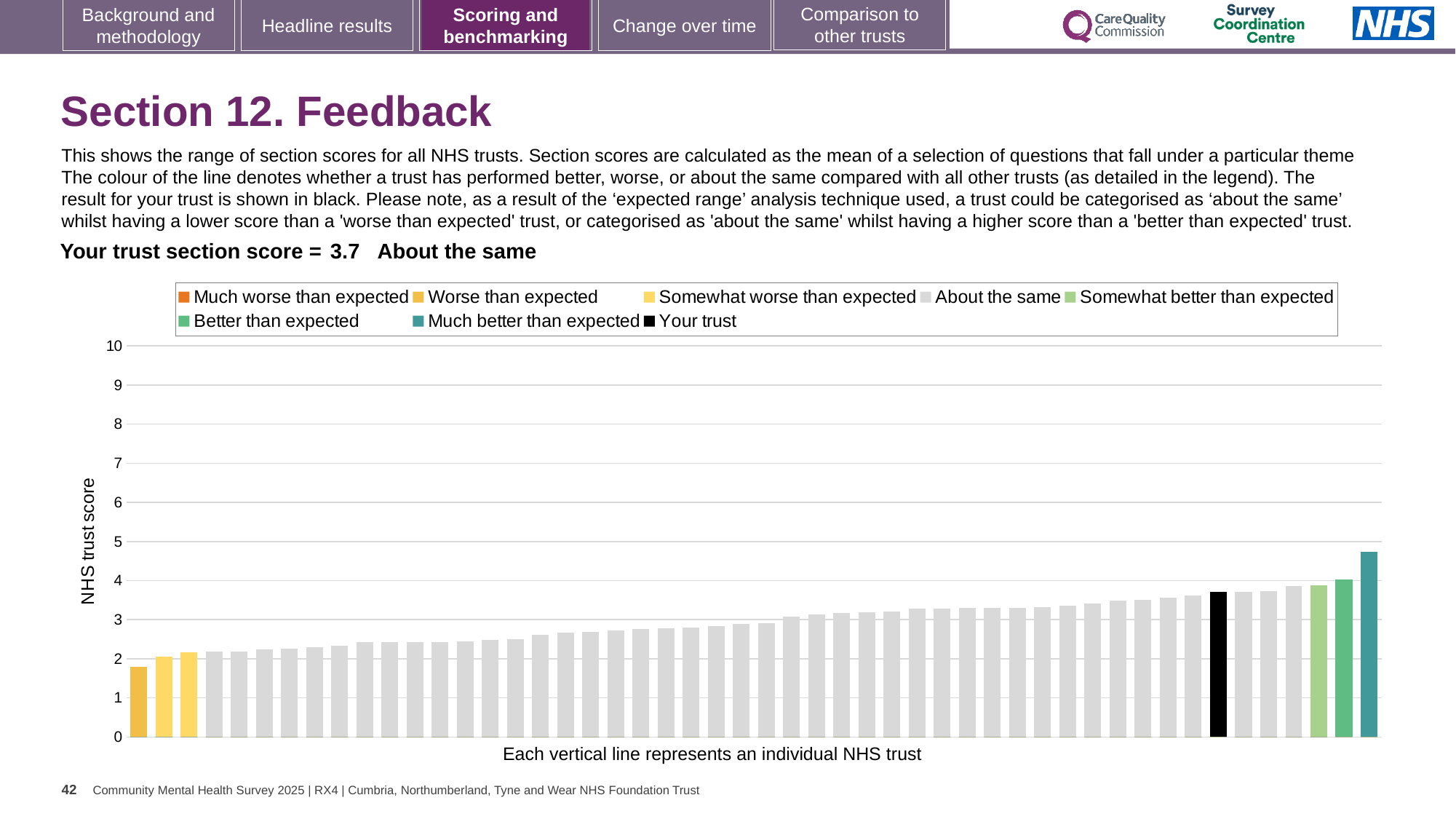
How many entries does the chart legend list? 8 Do the bar values rise or fall from left to right along the x axis? Rise What is the highest value shown on the vertical axis? 10 What colour is the bar representing your trust? Black Is the value for your trust greater or less than 3? greater Is the value of the tallest bar greater or less than 4? greater What kind of chart is shown on the slide? Bar chart Is the value of the tallest bar greater or less than 5? less What is the label on the vertical axis of the chart? NHS trust score Which performance category is your trust's section score placed in? About the same What is the section score for your trust shown on the slide? 3.7